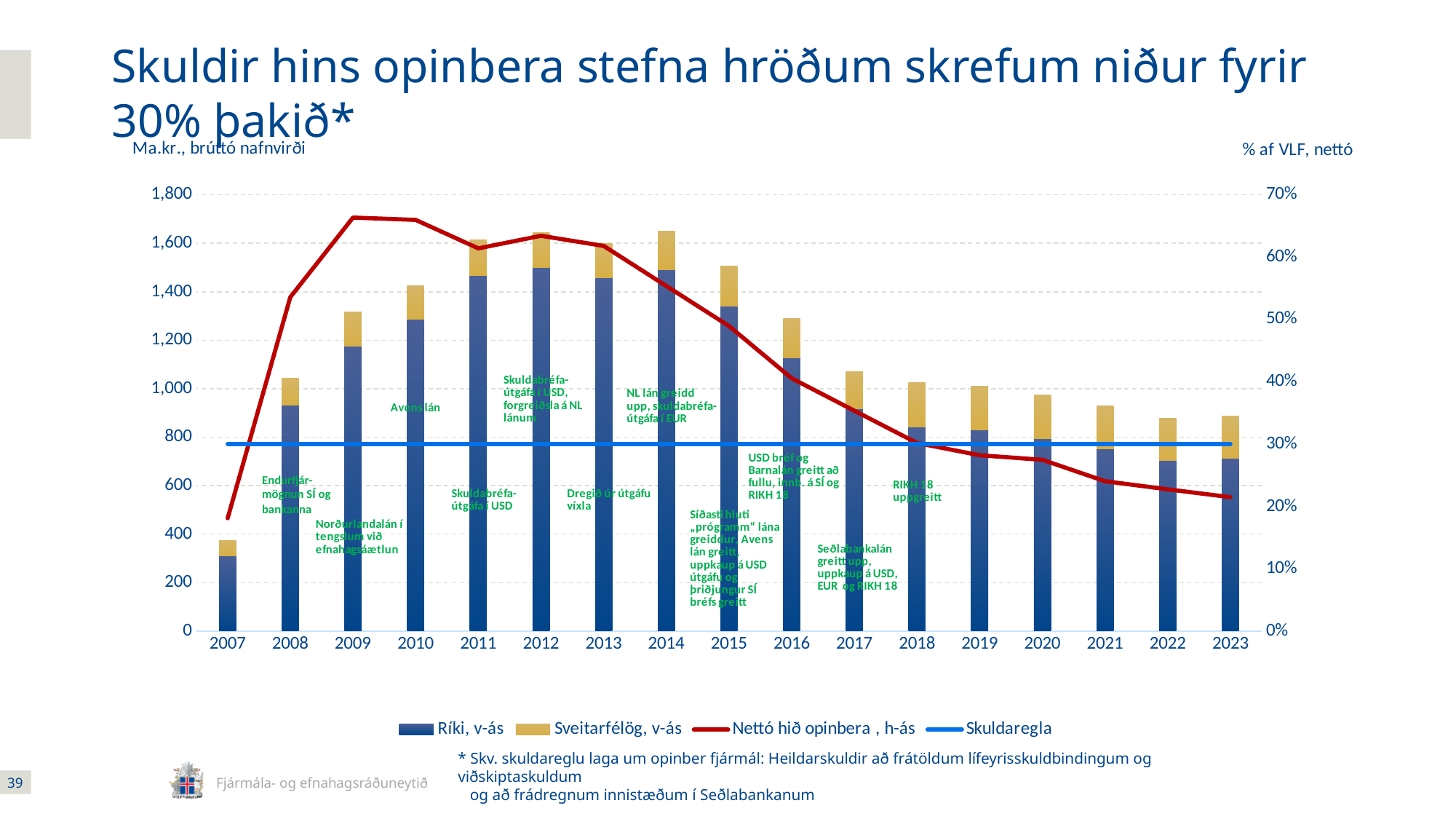
Which year has the lowest stacked bar (Ríki plus Sveitarfélög)? 2007 In which year is the 'Nettó hið opinbera, h-ás' line at its lowest? 2023 Is the 'Nettó hið opinbera, h-ás' value for 2023 greater or less than 30%? less Is the 'Nettó hið opinbera, h-ás' value for 2009 greater or less than 60%? greater What is the label of the right-hand vertical axis? % af VLF, nettó Which year has the larger stacked bar, 2008 or 2009? 2009 Is the total stacked bar value for 2007 greater or less than 400? less How many years are shown on the x axis of the chart? 17 How many series does the chart legend list? 4 Does the 'Nettó hið opinbera, h-ás' line rise or fall from 2010 to 2023? fall What kind of chart is shown on the slide? Stacked bar chart combined with line chart